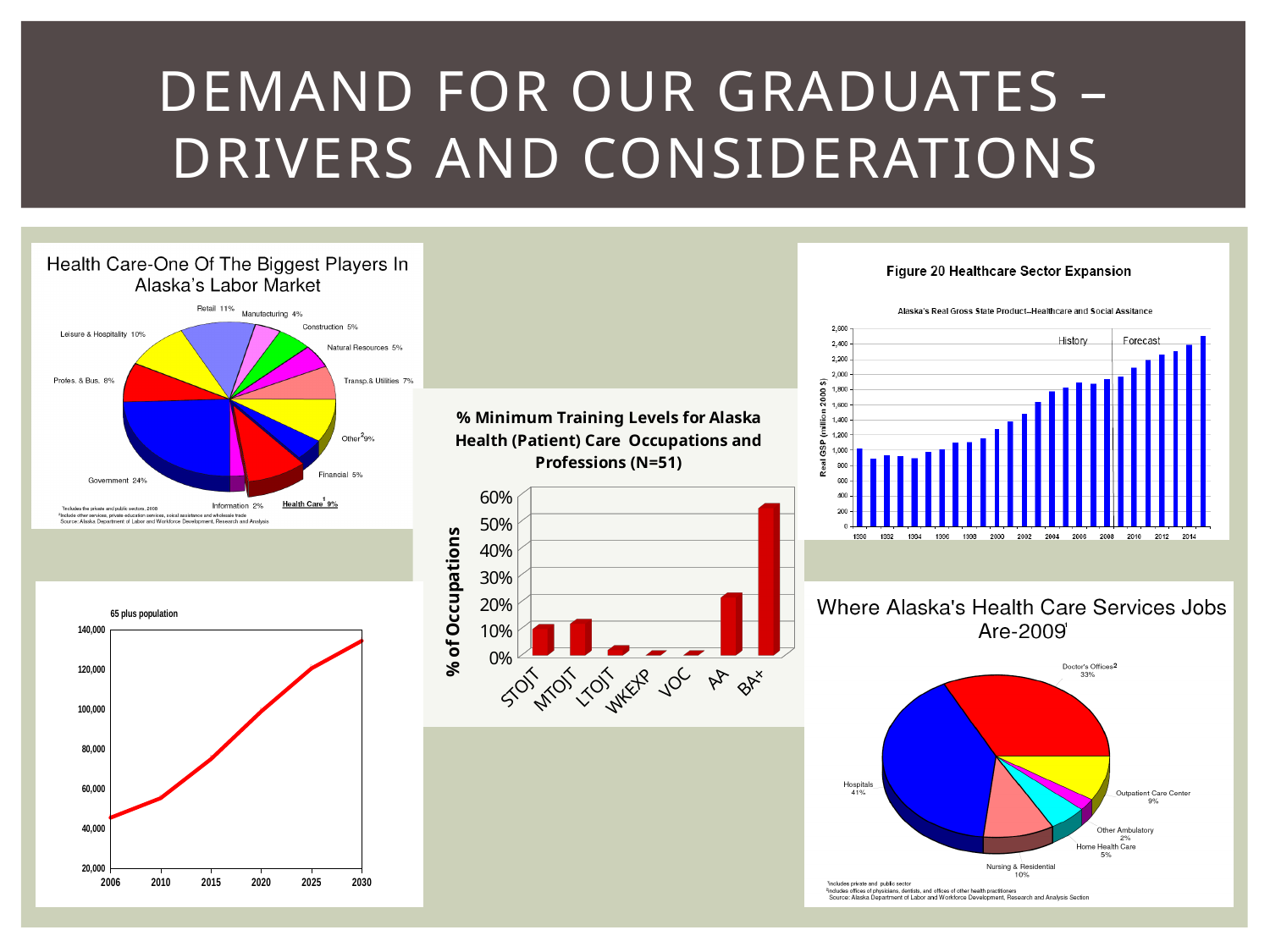
In the pie chart titled "Where Alaska's Health Care Services Jobs Are-2009", what share do Hospitals have? 41% In the pie chart titled "Where Alaska's Health Care Services Jobs Are-2009", which category has the smallest share? Other Ambulatory In the chart titled "% Minimum Training Levels for Alaska Health (Patient) Care Occupations and Professions (N=51)", which category has the highest value? BA+ In the chart titled "% Minimum Training Levels for Alaska Health (Patient) Care Occupations and Professions (N=51)", is the value for BA+ greater or less than 50%? greater In the chart titled "65 plus population" at the bottom left, do the values rise or fall from 2006 to 2030? rise In the pie chart titled "Where Alaska's Health Care Services Jobs Are-2009", which is larger: Doctor's Offices or Hospitals? Hospitals How many categories are shown on the x axis of the chart titled "% Minimum Training Levels for Alaska Health (Patient) Care Occupations and Professions (N=51)"? 7 In the pie chart titled "Health Care-One Of The Biggest Players In Alaska's Labor Market", which sector has the largest share? Government In the pie chart titled "Health Care-One Of The Biggest Players In Alaska's Labor Market", which sector has the smallest share? Information In the pie chart titled "Health Care-One Of The Biggest Players In Alaska's Labor Market", what is the difference between the Retail share and the Manufacturing share? 7% In the pie chart titled "Health Care-One Of The Biggest Players In Alaska's Labor Market", what share does Government have? 24% In the pie chart titled "Health Care-One Of The Biggest Players In Alaska's Labor Market", what share does Health Care have? 9%